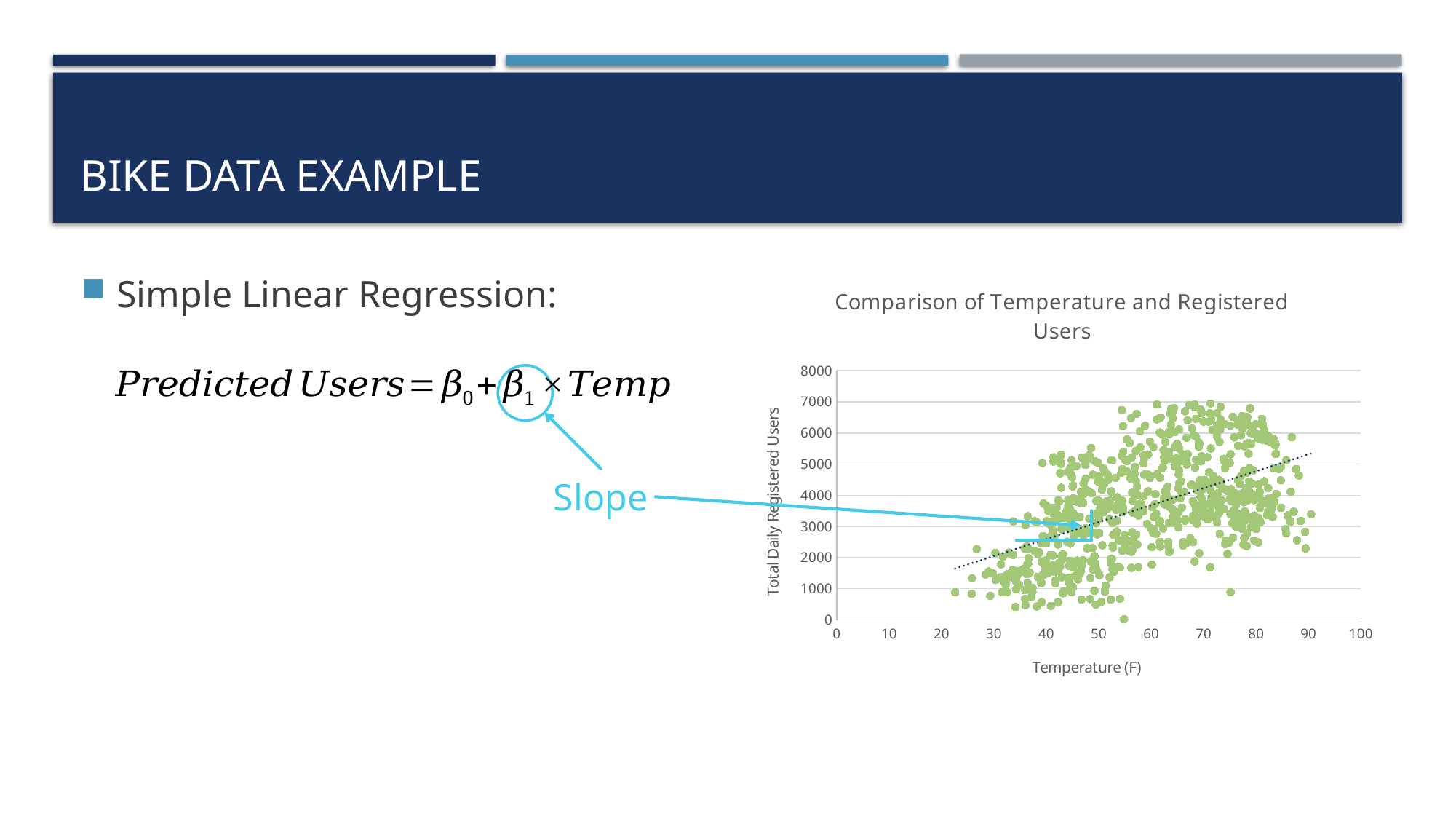
What is the label of the x axis of the chart? Temperature (F) Is the lowest temperature among the plotted points greater or less than 10 degrees F? greater What is the highest value shown on the x axis of the chart? 100 Does the dotted trend line in the chart slope upward or downward from left to right? upward What kind of chart is shown on the slide? scatter plot What is the title of the chart? Comparison of Temperature and Registered Users Are any plotted points in the chart above 8000 registered users? no Do the registered users generally rise or fall as temperature increases along the x axis? rise Is the highest plotted point in the chart greater or less than 6000 registered users? greater